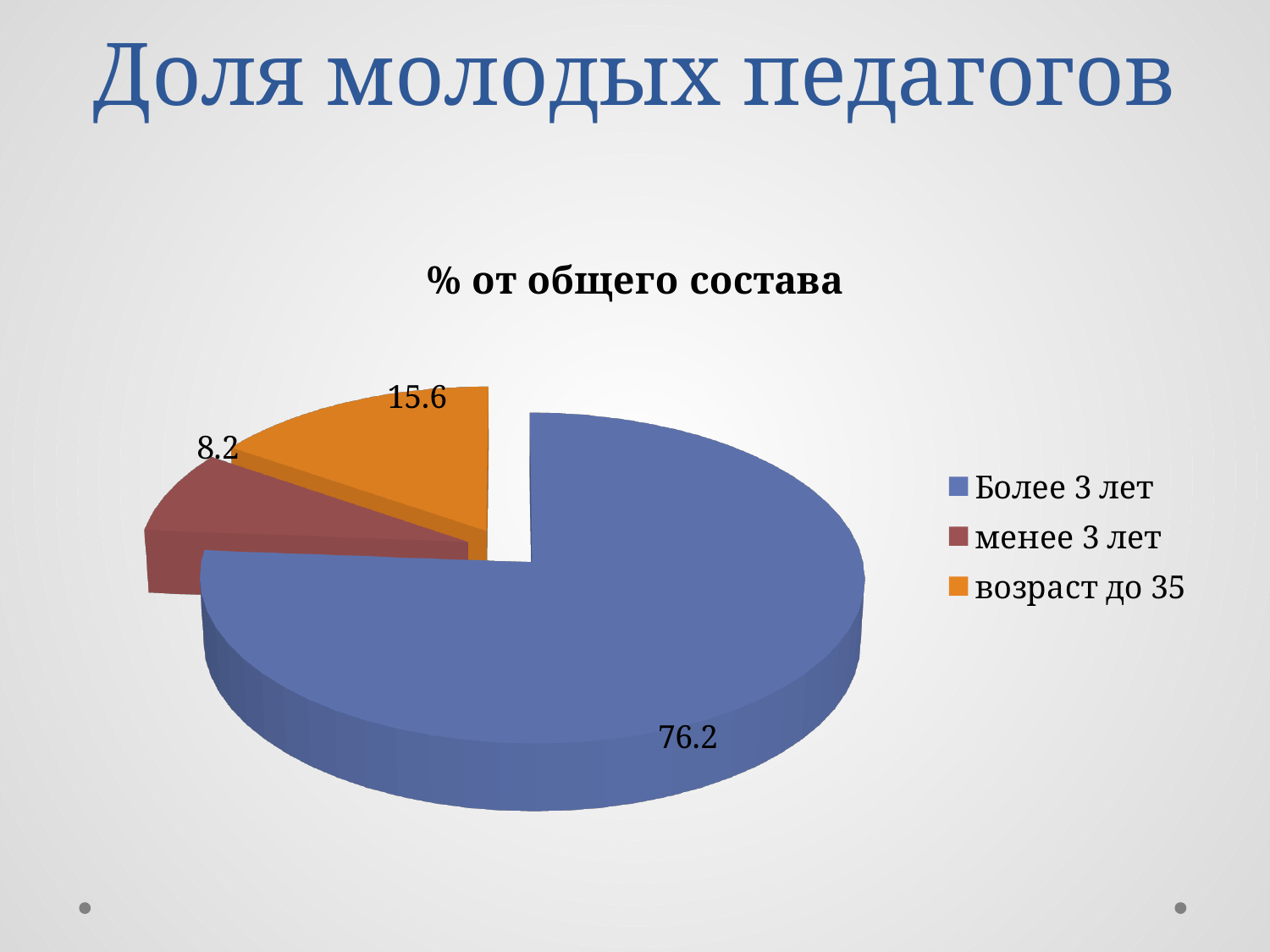
How many categories does the legend list? 3 Which is larger, the value for возраст до 35 or the value for менее 3 лет? возраст до 35 What is the value for менее 3 лет? 8.2 What is the value for Более 3 лет? 76.2 What kind of chart is shown on the slide? pie chart Which category has the largest slice? Более 3 лет What is the chart's title? % от общего состава What is the difference between the values for возраст до 35 and менее 3 лет? 7.4 Which category has the smallest slice? менее 3 лет What colour is the slice for возраст до 35? orange What is the value for возраст до 35? 15.6 What is the difference between the values for Более 3 лет and возраст до 35? 60.6